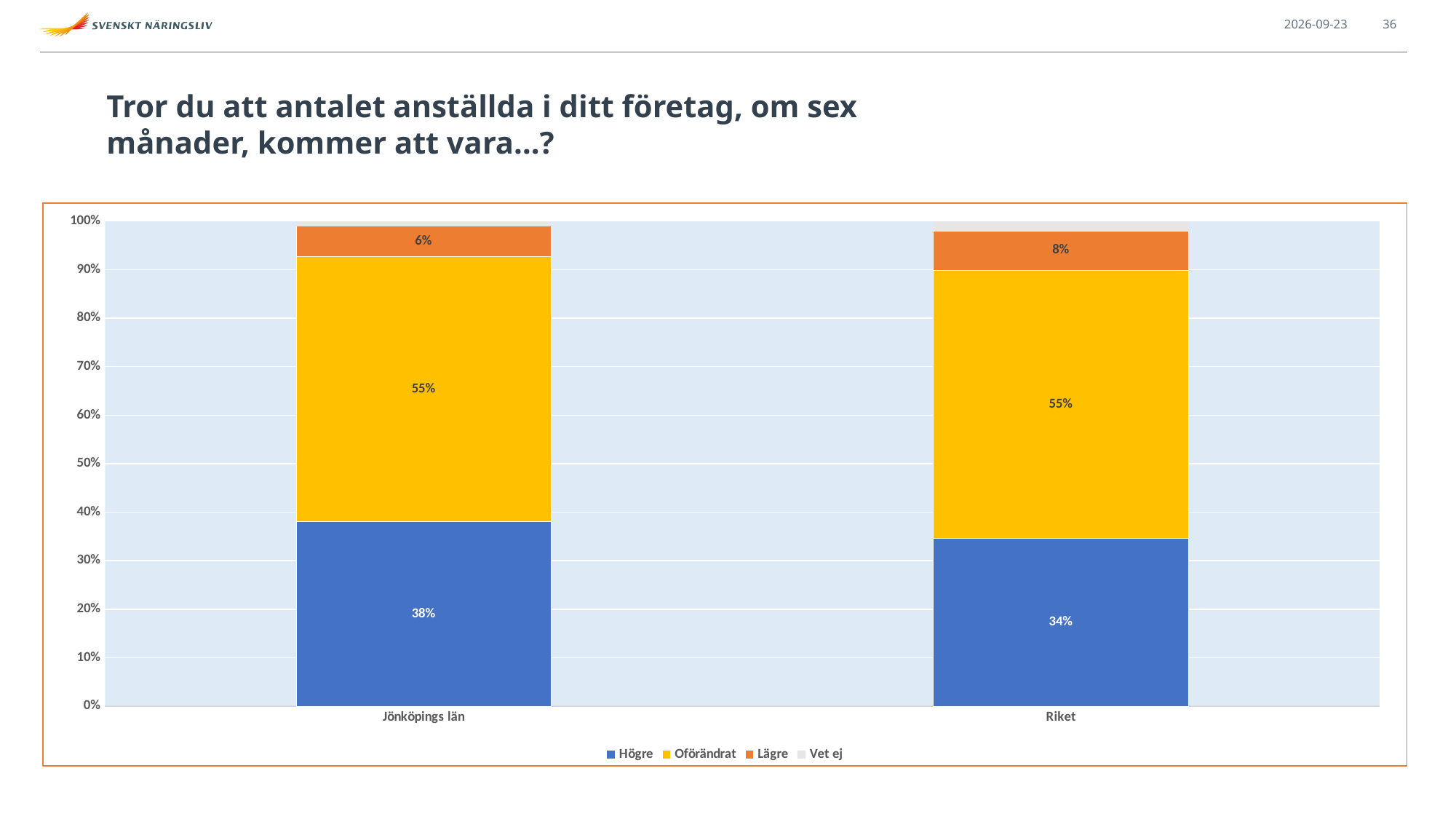
What percentage of respondents in Riket answered "Högre"? 34% How many categories are shown on the x axis? 2 What is the difference between the "Högre" values for Jönköpings län and Riket? 4 percentage points What is the value for "Lägre" in Jönköpings län? 6% What kind of chart is shown on the slide? Stacked bar chart What is the difference between the "Lägre" values for Riket and Jönköpings län? 2 percentage points What is the value for "Oförändrat" in Jönköpings län? 55% Which category has the higher value for "Högre", Jönköpings län or Riket? Jönköpings län How many series does the legend list? 4 Which response has the largest share in Riket? Oförändrat What is the value for "Lägre" in Riket? 8% What percentage of respondents in Jönköpings län answered "Högre"? 38%